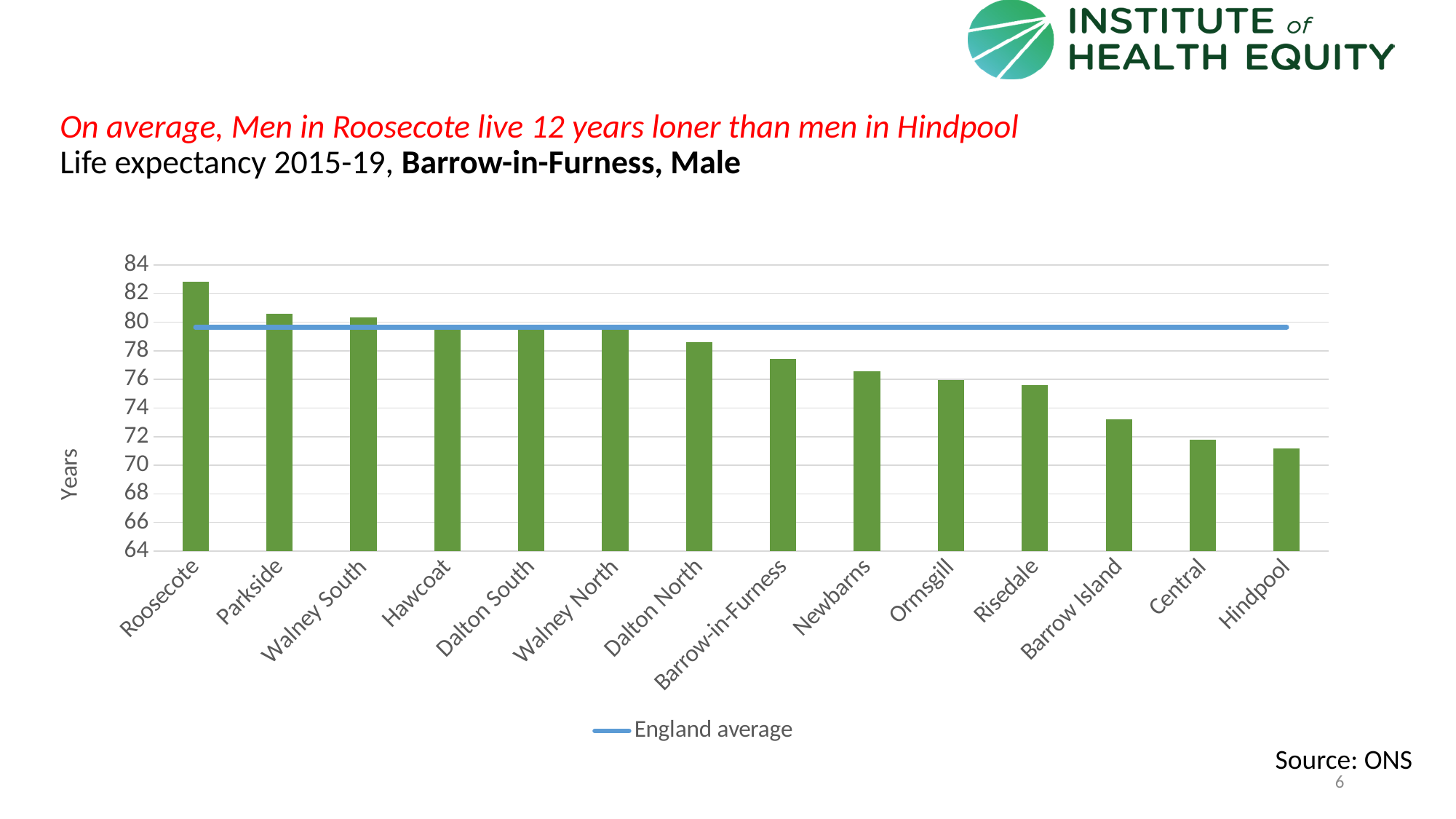
Do the bar values rise or fall moving from left to right along the x axis? Fall Which has the higher male life expectancy, Newbarns or Central? Newbarns Which ward has the lowest male life expectancy in the chart? Hindpool Which ward has the highest male life expectancy in the chart? Roosecote Is the value for Hindpool greater or less than 72? less Is the value for Roosecote greater or less than 82? greater Is the value for Dalton North greater or less than 78? greater How many wards are shown on the x axis of the chart? 14 How many entries does the chart legend list? 1 What does the blue horizontal line in the chart represent? England average What kind of chart is shown on the slide? Bar chart